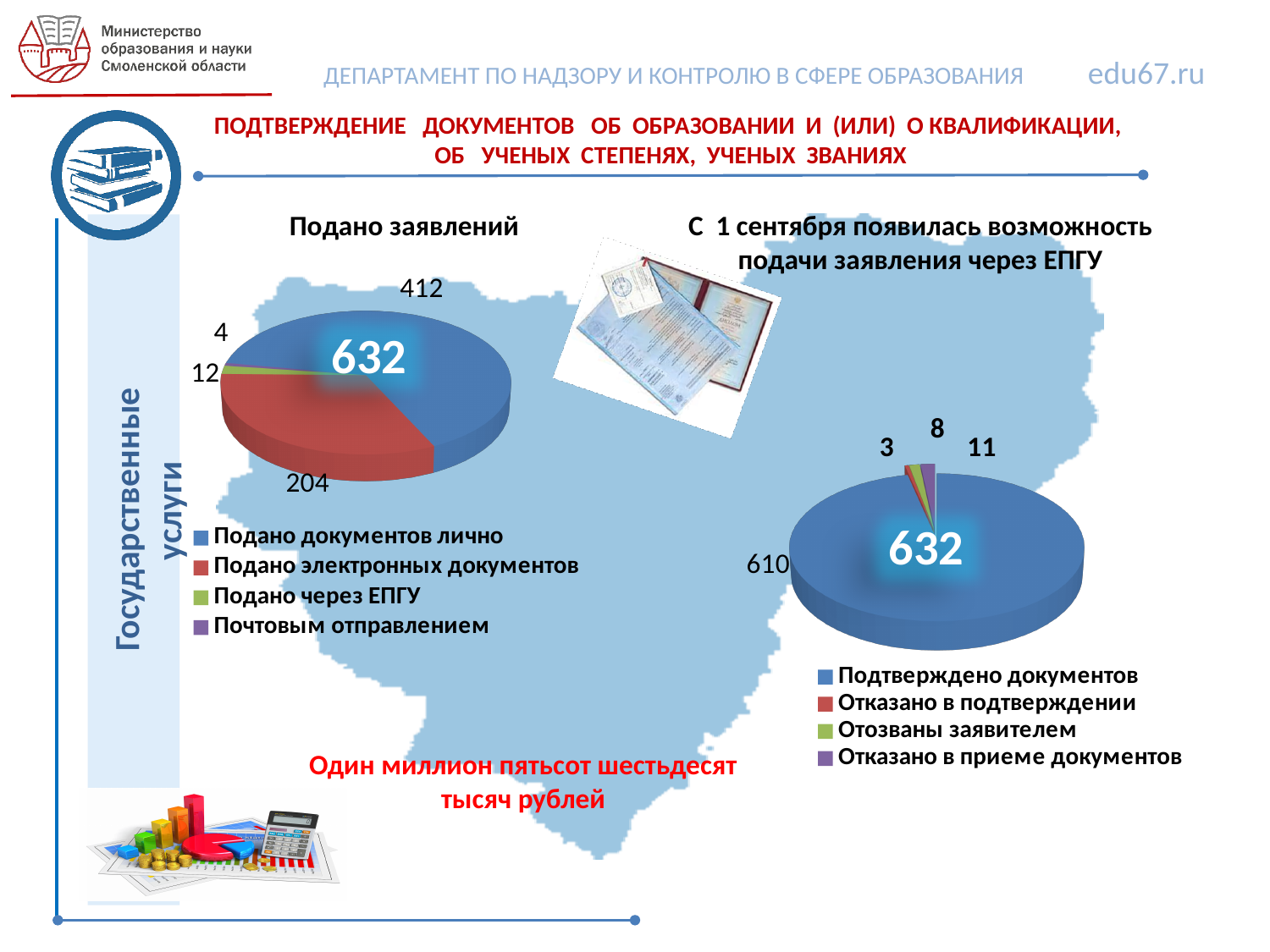
On the right pie chart, what is the total of all four categories? 632 On the left pie chart titled 'Подано заявлений', which category has the smallest value? Почтовым отправлением On the left pie chart titled 'Подано заявлений', what is the value for 'Подано документов лично'? 412 On the left pie chart titled 'Подано заявлений', how many categories does the legend list? 4 On the left pie chart titled 'Подано заявлений', what is the value for 'Подано через ЕПГУ'? 12 What type of chart is the left chart titled 'Подано заявлений'? pie chart On the left pie chart titled 'Подано заявлений', what is the value for 'Подано электронных документов'? 204 On the right pie chart, what is the value for 'Подтверждено документов'? 610 On the right pie chart, what is the value for 'Отказано в приеме документов'? 11 On the right pie chart, which category has the largest value? Подтверждено документов On the right pie chart, which is larger: 'Отозваны заявителем' or 'Отказано в подтверждении'? Отозваны заявителем On the left pie chart titled 'Подано заявлений', what is the difference between 'Подано документов лично' and 'Подано электронных документов'? 208